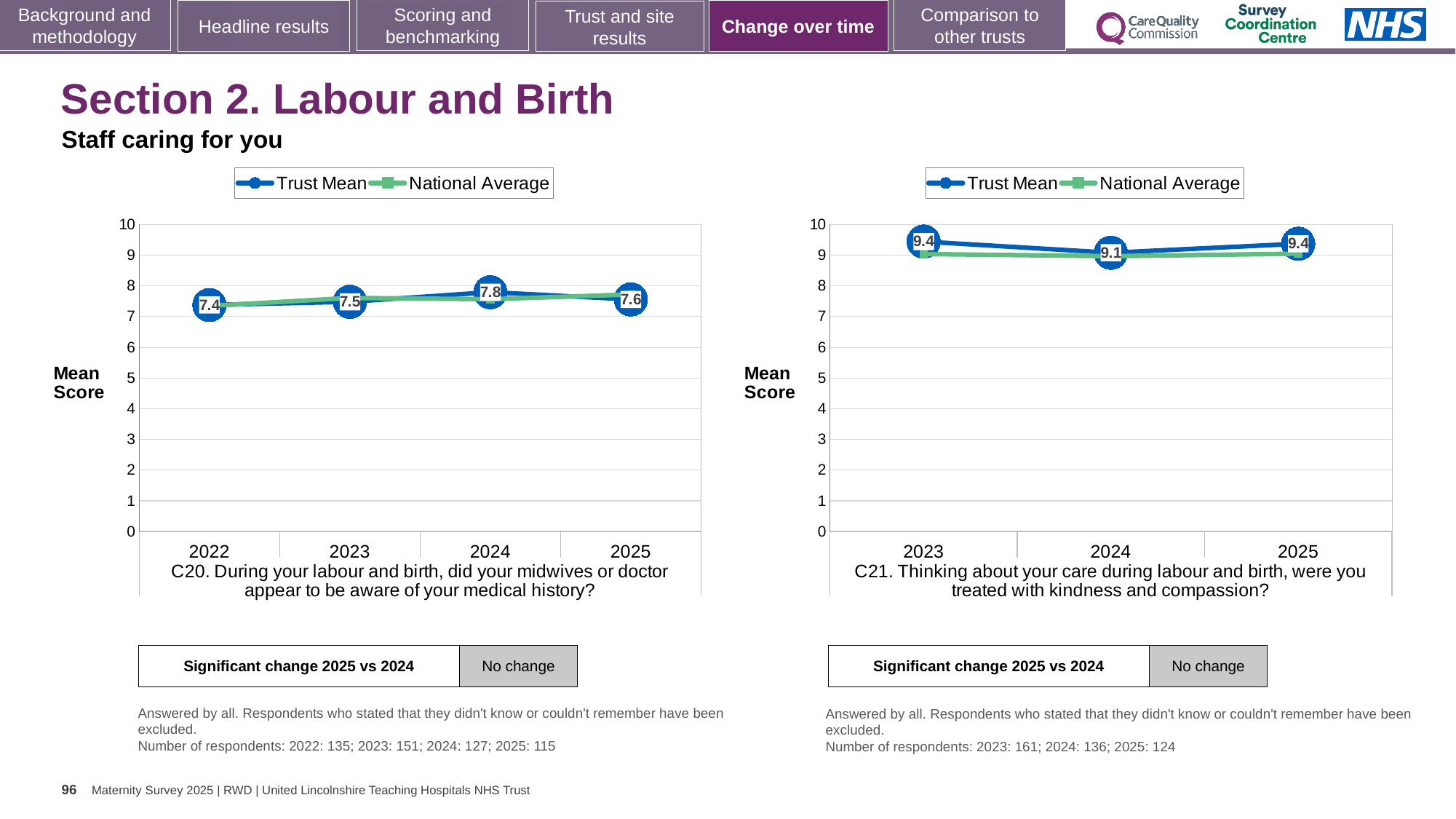
On the right chart (C21), what is the Trust Mean score for 2024? 9.1 On the left chart (C20), what is the difference between the Trust Mean scores for 2024 and 2023? 0.3 On the left chart (C20), what is the Trust Mean score for 2022? 7.4 On the left chart (C20), how many years are plotted on the x axis? 4 On the right chart (C21), how many series does the legend list? 2 What kind of chart is the right chart (C21)? Line chart On the left chart (C20), which year has the lowest Trust Mean score? 2022 On the left chart (C20), what is the Trust Mean score for 2024? 7.8 On the left chart (C20), is the National Average value for 2022 greater or less than 5? greater On the right chart (C21), what is the difference between the Trust Mean scores for 2025 and 2024? 0.3 On the left chart (C20), which year has the highest Trust Mean score? 2024 On the right chart (C21), which year has the lowest Trust Mean score? 2024